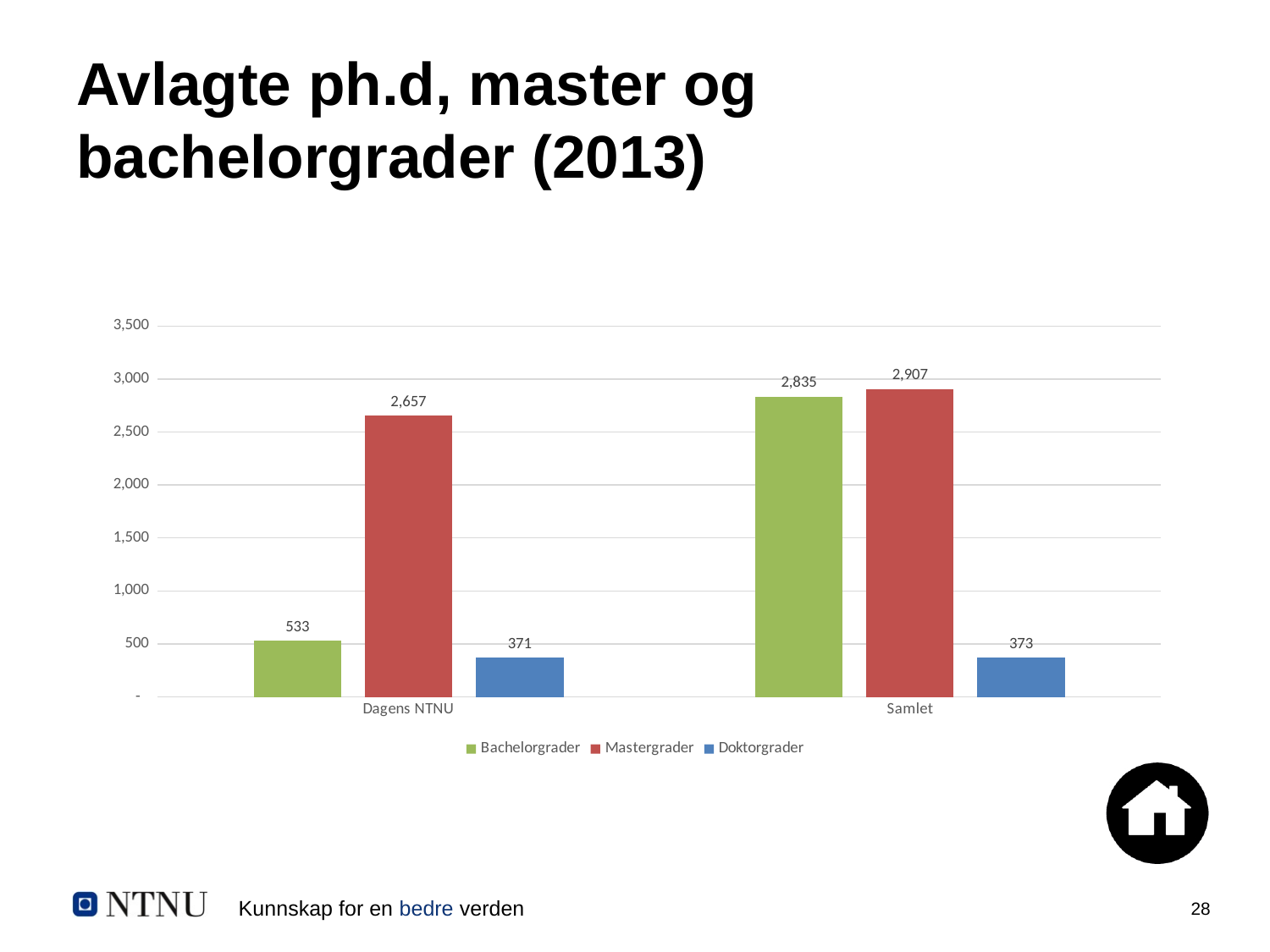
What is the difference between Bachelorgrader in Samlet and Bachelorgrader in Dagens NTNU? 2,302 How many series does the legend list? 3 What is the value for Bachelorgrader in the Samlet category? 2,835 Which series has the lowest value in the Dagens NTNU category? Doktorgrader Which is larger: Bachelorgrader for Dagens NTNU or Doktorgrader for Dagens NTNU? Bachelorgrader for Dagens NTNU What kind of chart is shown on the slide? Bar chart What is the value for Doktorgrader in the Dagens NTNU category? 371 How many categories are shown on the x axis? 2 Which series has the highest value in the Samlet category? Mastergrader What is the value for Mastergrader in the Dagens NTNU category? 2,657 Is the value for Mastergrader in Dagens NTNU greater or less than 2,500? greater What is the difference between Mastergrader and Bachelorgrader in the Samlet category? 72